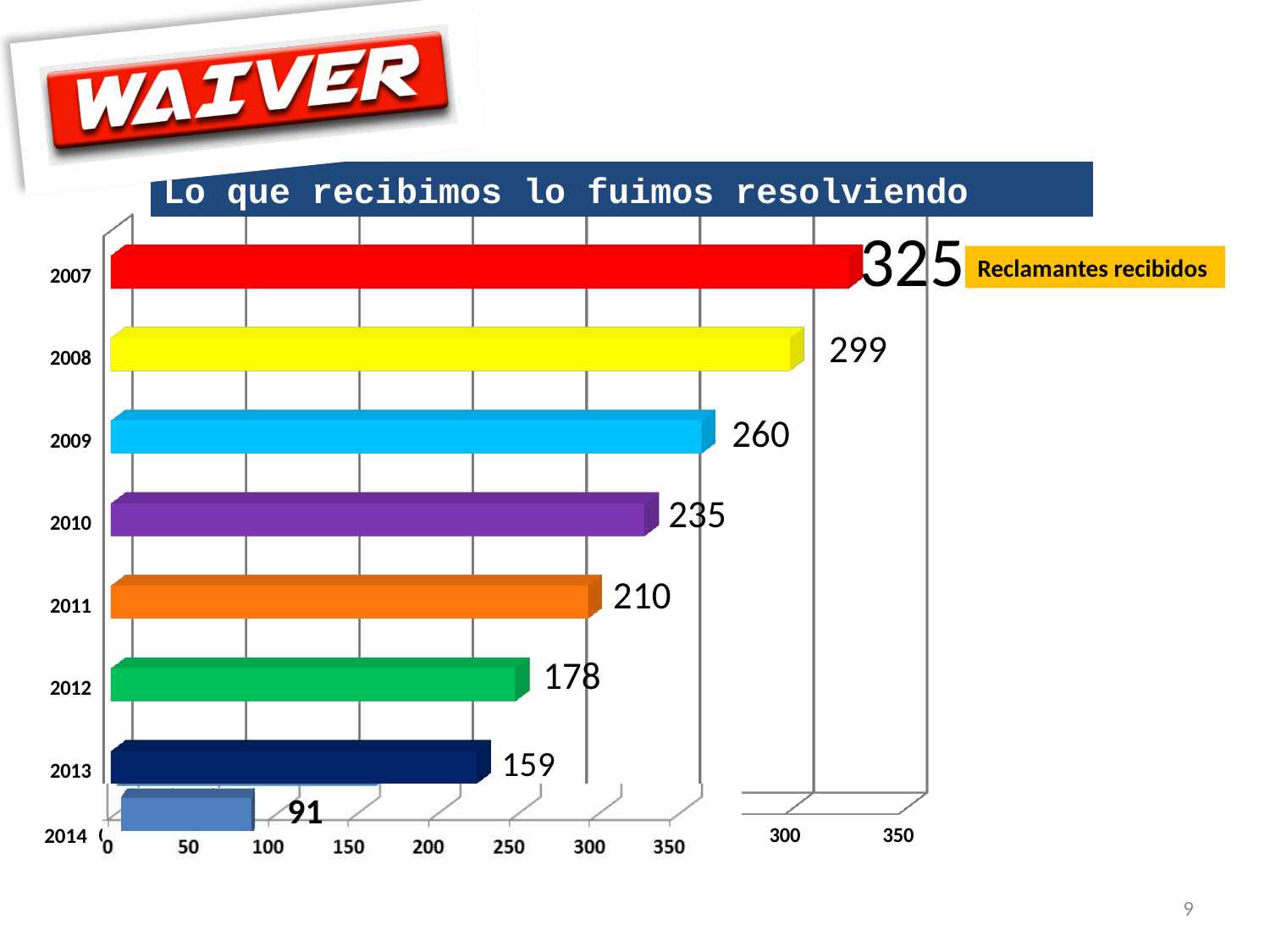
Do the values rise or fall from 2007 to 2014? fall What is the difference between the values for 2007 and 2014? 234 Which year has the highest value? 2007 How many years are shown in the chart? 8 What is the value for 2010? 235 What is the difference between the values for 2008 and 2009? 39 What series name does the legend show? Reclamantes recibidos Which year has the lowest value? 2014 What kind of chart is shown on the slide? bar chart What is the value for 2014? 91 Which is larger, the value for 2011 or the value for 2012? 2011 What is the value for 2007? 325